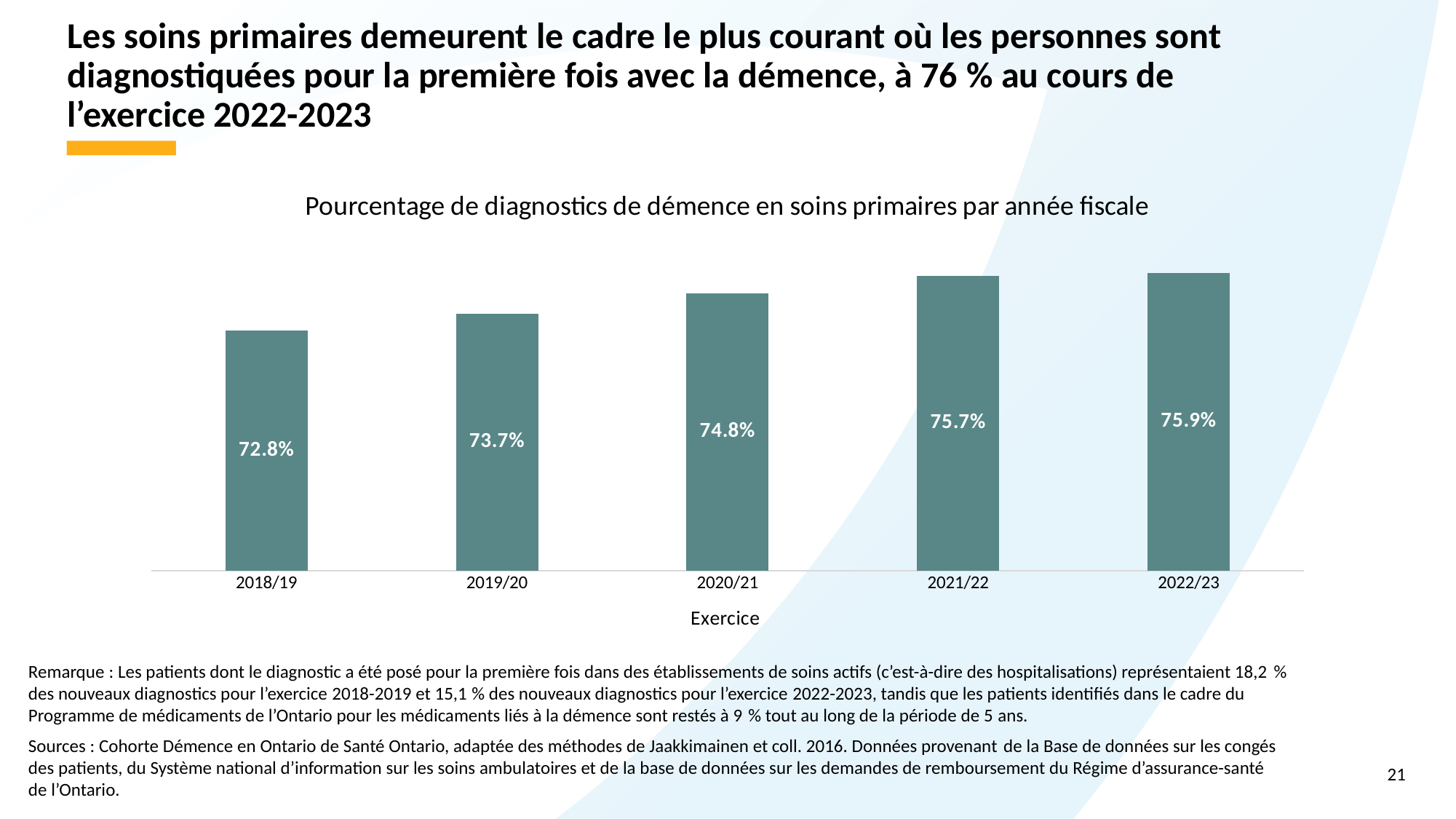
What is the difference between the values for 2022/23 and 2018/19? 3.1% Do the values rise or fall from 2018/19 to 2022/23? rise What is the value for 2018/19? 72.8% How many fiscal years are shown on the chart? 5 What is the value for 2021/22? 75.7% What is the difference between the values for 2020/21 and 2019/20? 1.1% What is the value for 2022/23? 75.9% Which fiscal year has the lowest percentage? 2018/19 What kind of chart is this? bar chart Which is larger, the value for 2019/20 or the value for 2020/21? 2020/21 Which fiscal year has the highest percentage? 2022/23 What is the value for 2020/21? 74.8%